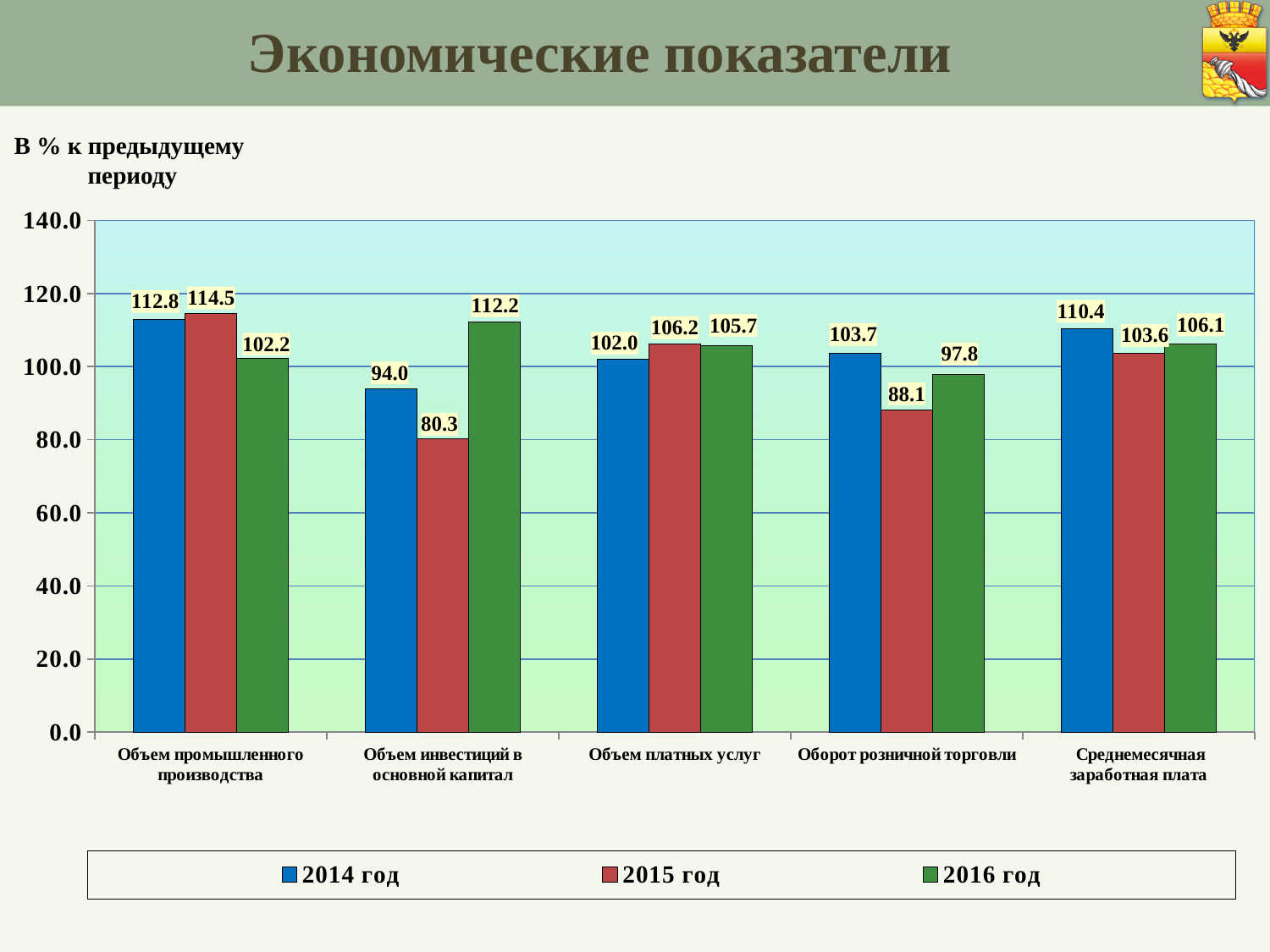
How many series does the legend list? 3 Is the value for 2015 год for Оборот розничной торговли greater or less than 100.0? less Which category has the lowest value for 2016 год? Оборот розничной торговли What is the value for 2014 год for Оборот розничной торговли? 103.7 What is the difference between the 2016 год and 2015 год values for Объем инвестиций в основной капитал? 31.9 What is the value for 2016 год for Среднемесячная заработная плата? 106.1 Which category has the highest value for 2015 год? Объем промышленного производства What is the value for 2015 год for Объем инвестиций в основной капитал? 80.3 How many categories are shown on the x axis? 5 What is the title of the slide? Экономические показатели Which is larger for Объем платных услуг: the 2014 год value or the 2015 год value? 2015 год What kind of chart is shown on the slide? bar chart